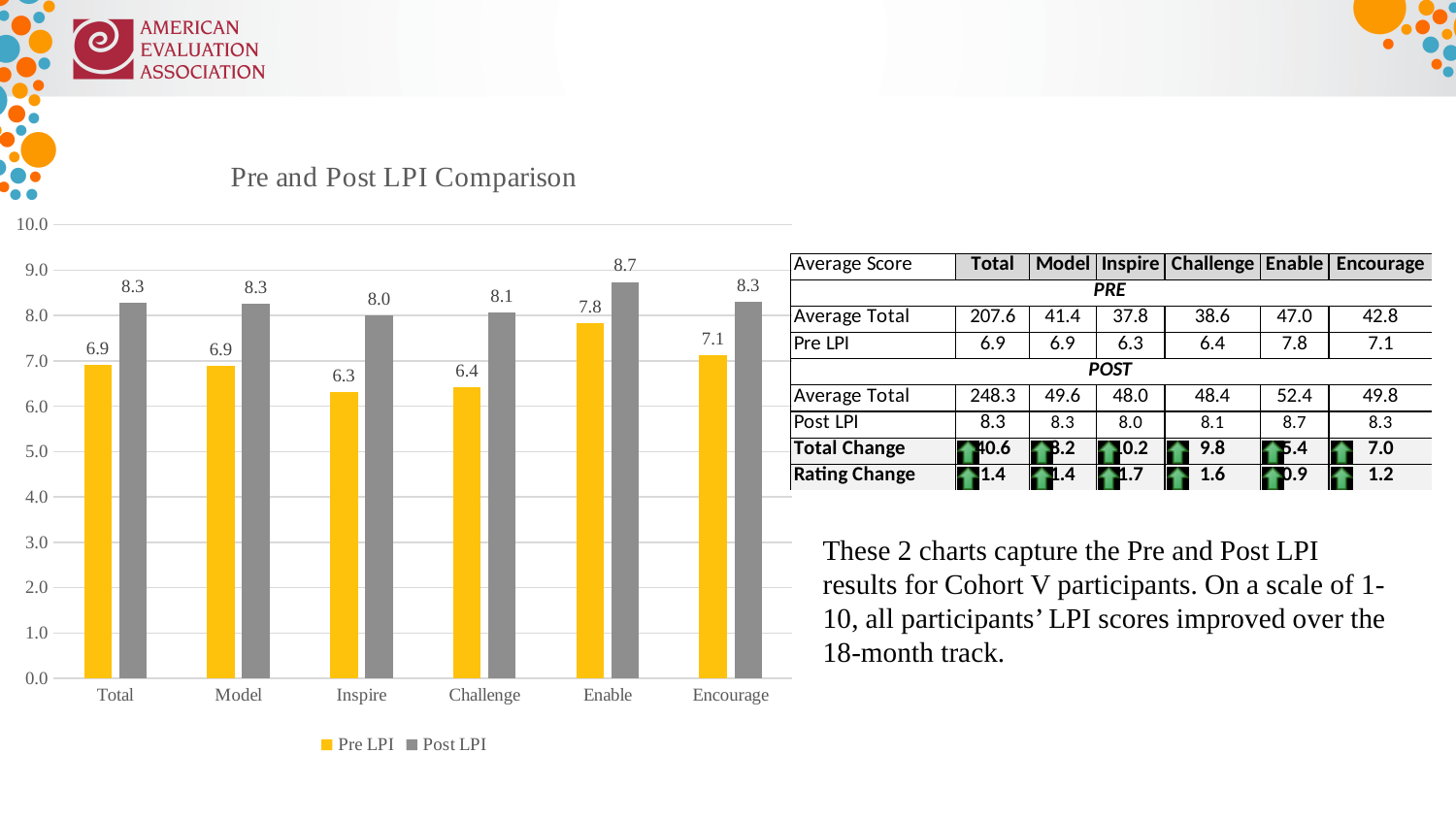
How many categories are shown on the x axis of the chart? 6 What is the Pre LPI value for Inspire? 6.3 What is the Post LPI value for Challenge? 8.1 What is the difference between the Post LPI and Pre LPI values for Total? 1.4 Which is larger, the Pre LPI value for Enable or the Pre LPI value for Challenge? Enable Which category has the lowest Pre LPI value? Inspire How many series does the chart's legend list? 2 What type of chart is shown on the slide? Bar chart Is the Post LPI value for Inspire greater or less than 7.0? greater Which category has the highest Post LPI value? Enable What is the Post LPI value for Enable? 8.7 What is the Pre LPI value for Encourage? 7.1